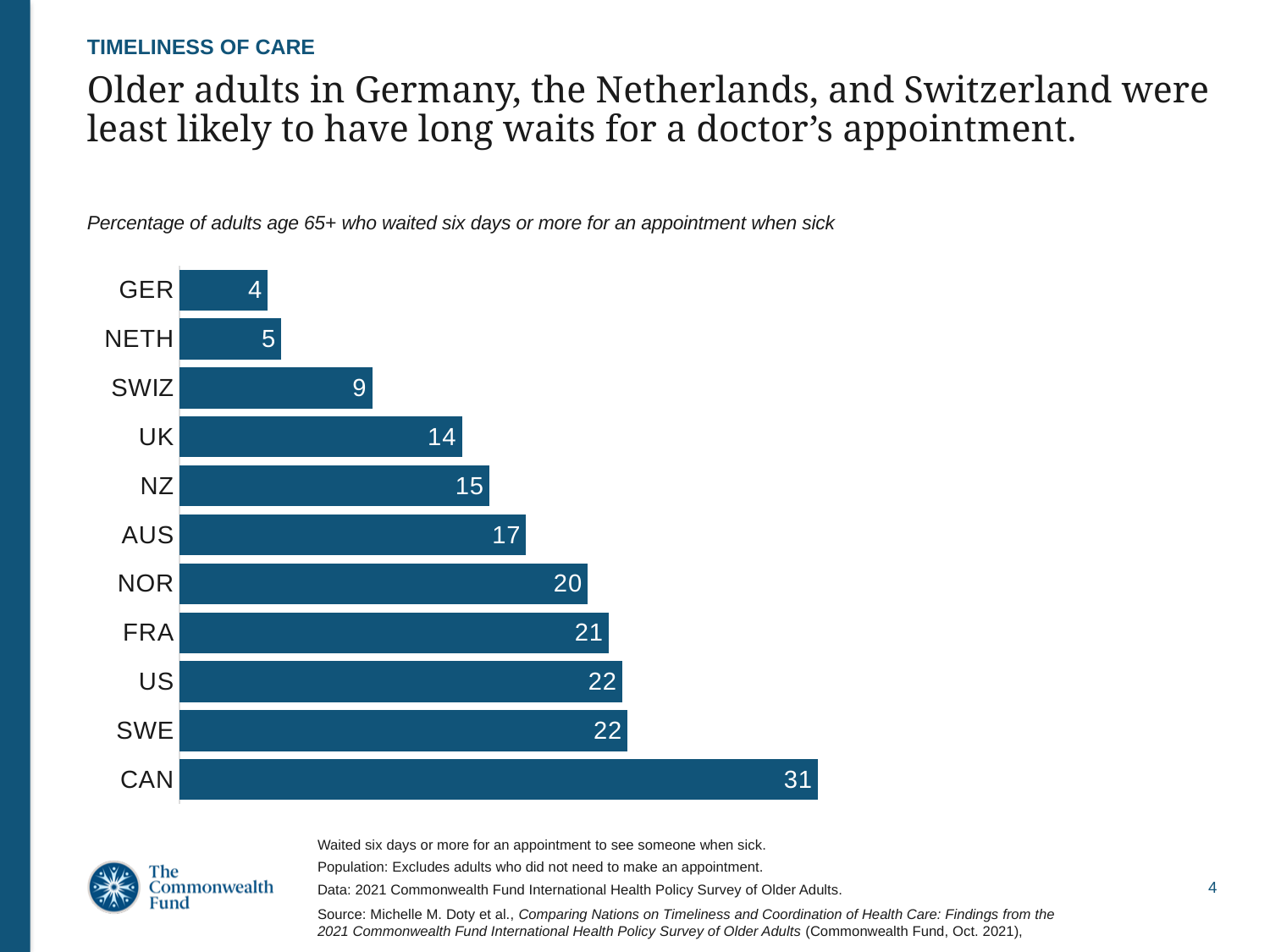
Which country has the lowest value? GER What is the subtitle describing the measure plotted in the chart? Percentage of adults age 65+ who waited six days or more for an appointment when sick Which country has the highest value? CAN Which is larger, the value for FRA or the value for SWIZ? FRA What is the value for CAN? 31 What is the difference between the values for CAN and GER? 27 What is the value for NOR? 20 Which is larger, the value for AUS or the value for NZ? AUS What is the value for SWIZ? 9 How many countries are shown in the chart? 11 What kind of chart is shown on the slide? Bar chart What is the difference between the values for UK and NETH? 9